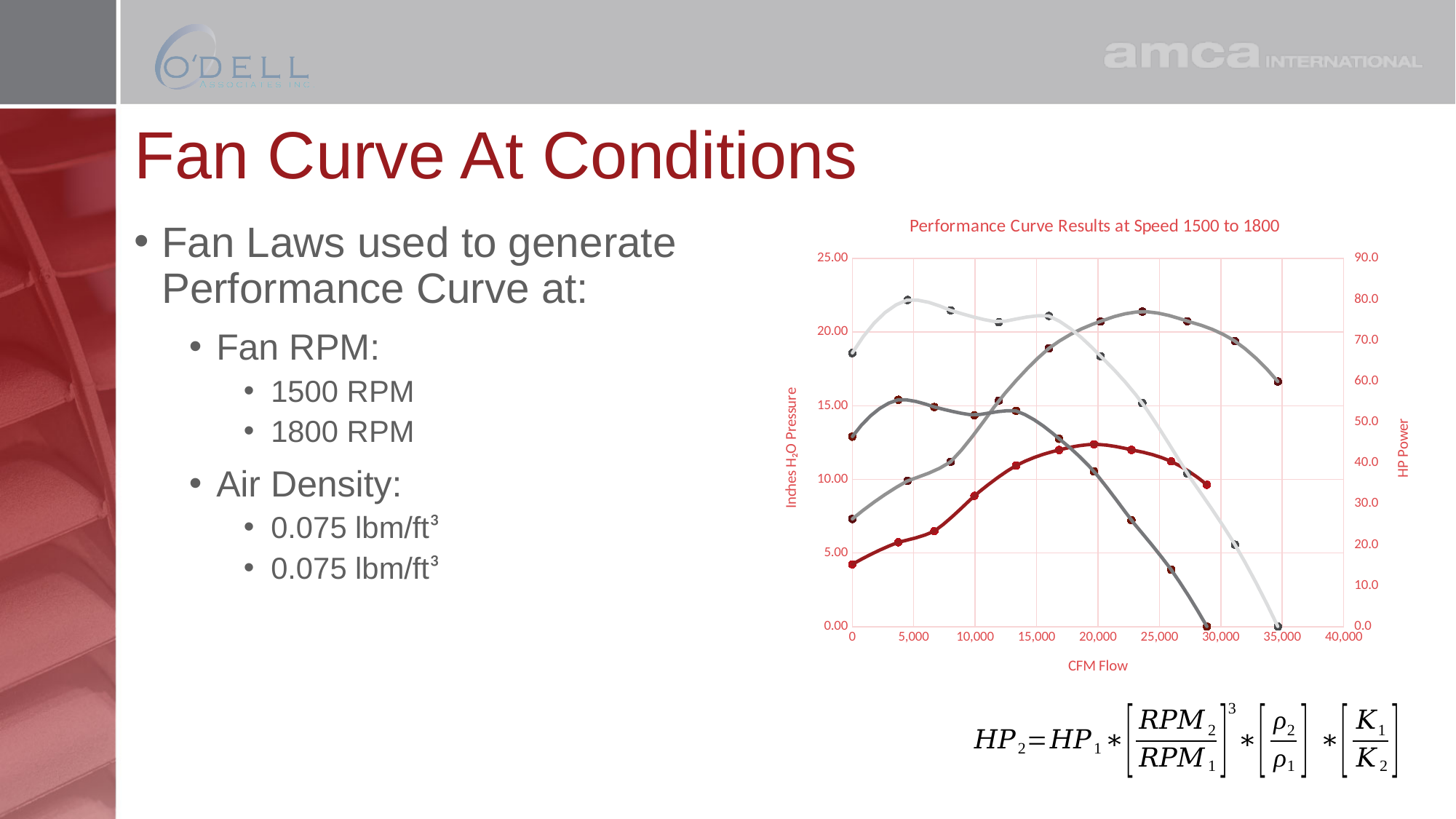
What is the title of the chart? Performance Curve Results at Speed 1500 to 1800 What is the highest tick value shown on the x axis of the chart? 40,000 Which line reaches the bottom of the chart at a larger CFM Flow value, the dark grey line or the light grey line? the light grey line What type of chart is shown on the slide? Line chart Does the dark red line rise or fall between 0 and 20,000 CFM Flow? rise What is the highest tick value shown on the left-hand Inches H2O Pressure axis? 25.00 Does the light grey line rise or fall between 20,000 and 35,000 CFM Flow? fall What is the title of the x axis of the chart? CFM Flow What is the highest tick value shown on the right-hand HP Power axis? 90.0 Does the peak of the light grey line lie above or below the 20.00 gridline of the left axis? above How many lines are plotted on the chart? 4 Does the peak of the dark red line lie above or below the 10.00 gridline of the left axis? above